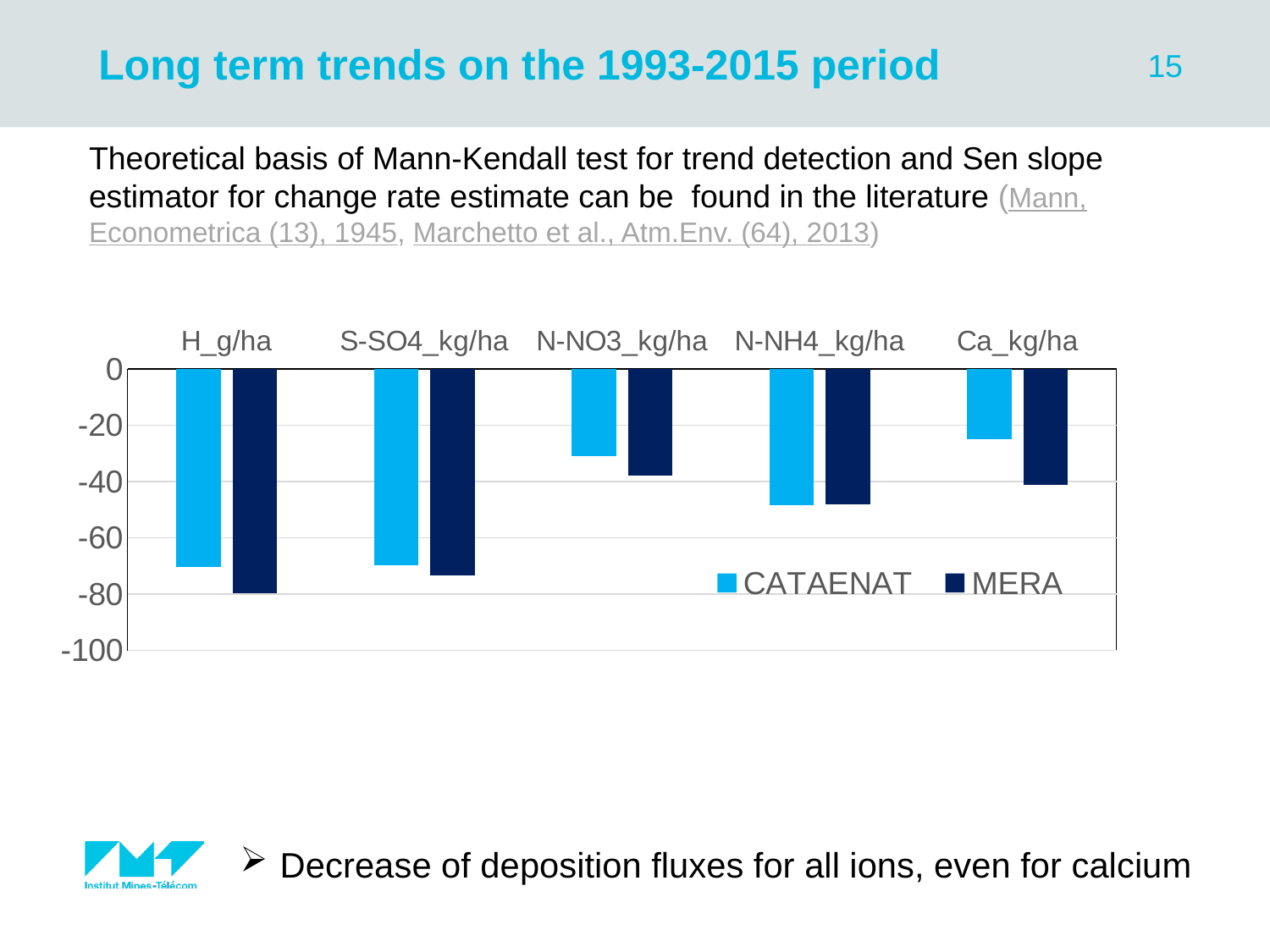
Which category has the lowest (most negative) MERA value? H_g/ha Which colour represents the MERA series in the chart? dark blue Is the MERA value for H_g/ha greater or less than -60? less What kind of chart is shown on the slide? bar chart Is the MERA value for N-NO3_kg/ha greater or less than -20? less Is the CATAENAT value for Ca_kg/ha greater or less than -40? greater What are the two series named in the chart legend? CATAENAT and MERA How many categories are shown on the x axis of the chart? 5 For Ca_kg/ha, which series has the larger (less negative) value, CATAENAT or MERA? CATAENAT Which category has the highest (closest to zero) CATAENAT value? Ca_kg/ha How many series does the chart legend list? 2